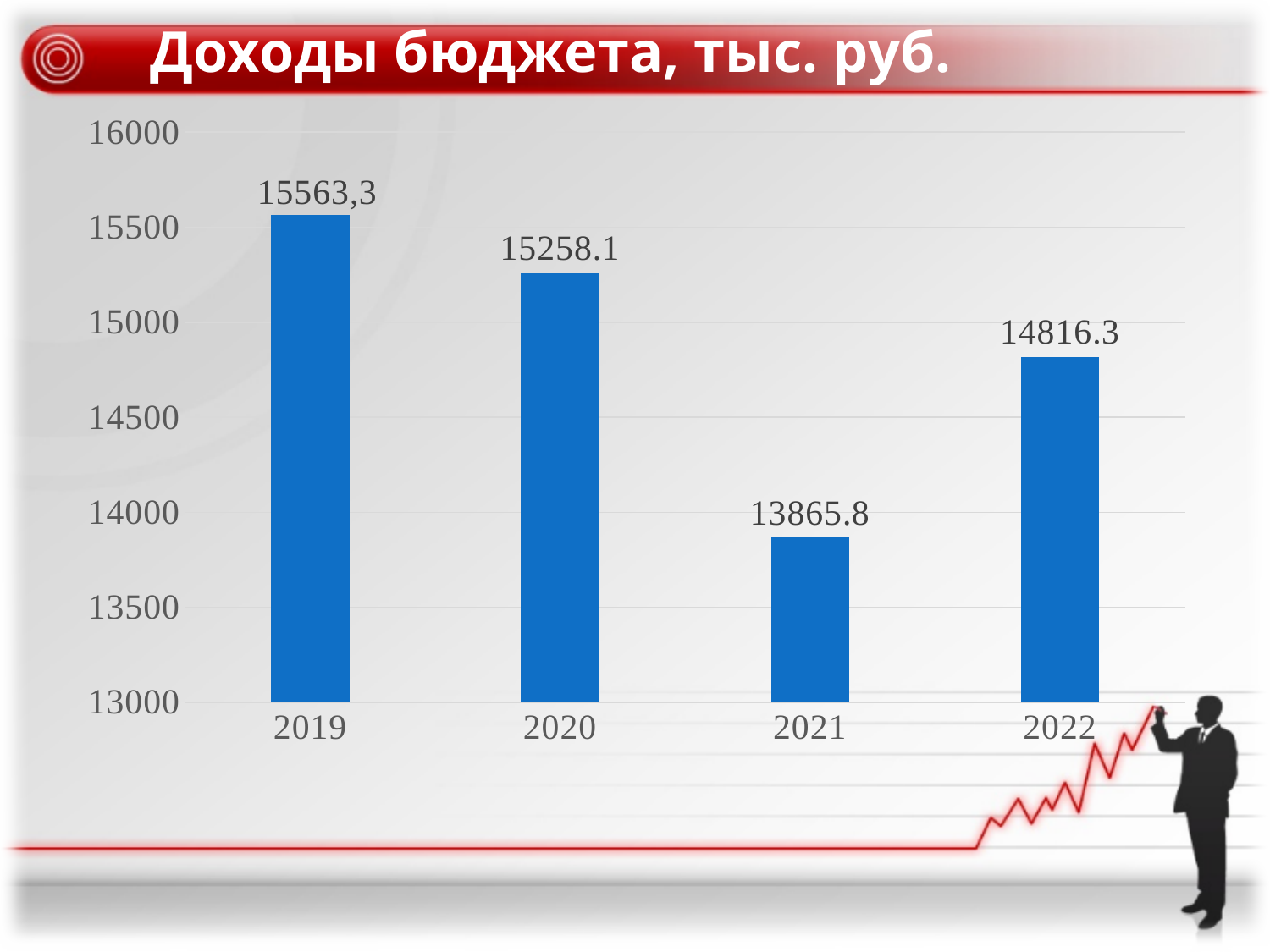
What is the value for 2019? 15563,3 What is the title of the chart? Доходы бюджета, тыс. руб. How many years are shown on the x axis? 4 What is the difference between the values for 2022 and 2021? 950.5 What is the difference between the values for 2020 and 2021? 1392.3 What is the value for 2022? 14816.3 Is the value for 2021 greater or less than 14000? less Which year has the highest value? 2019 What kind of chart is shown on the slide? bar chart What is the value for 2021? 13865.8 Which is larger, the value for 2020 or the value for 2022? 2020 Which year has the lowest value? 2021